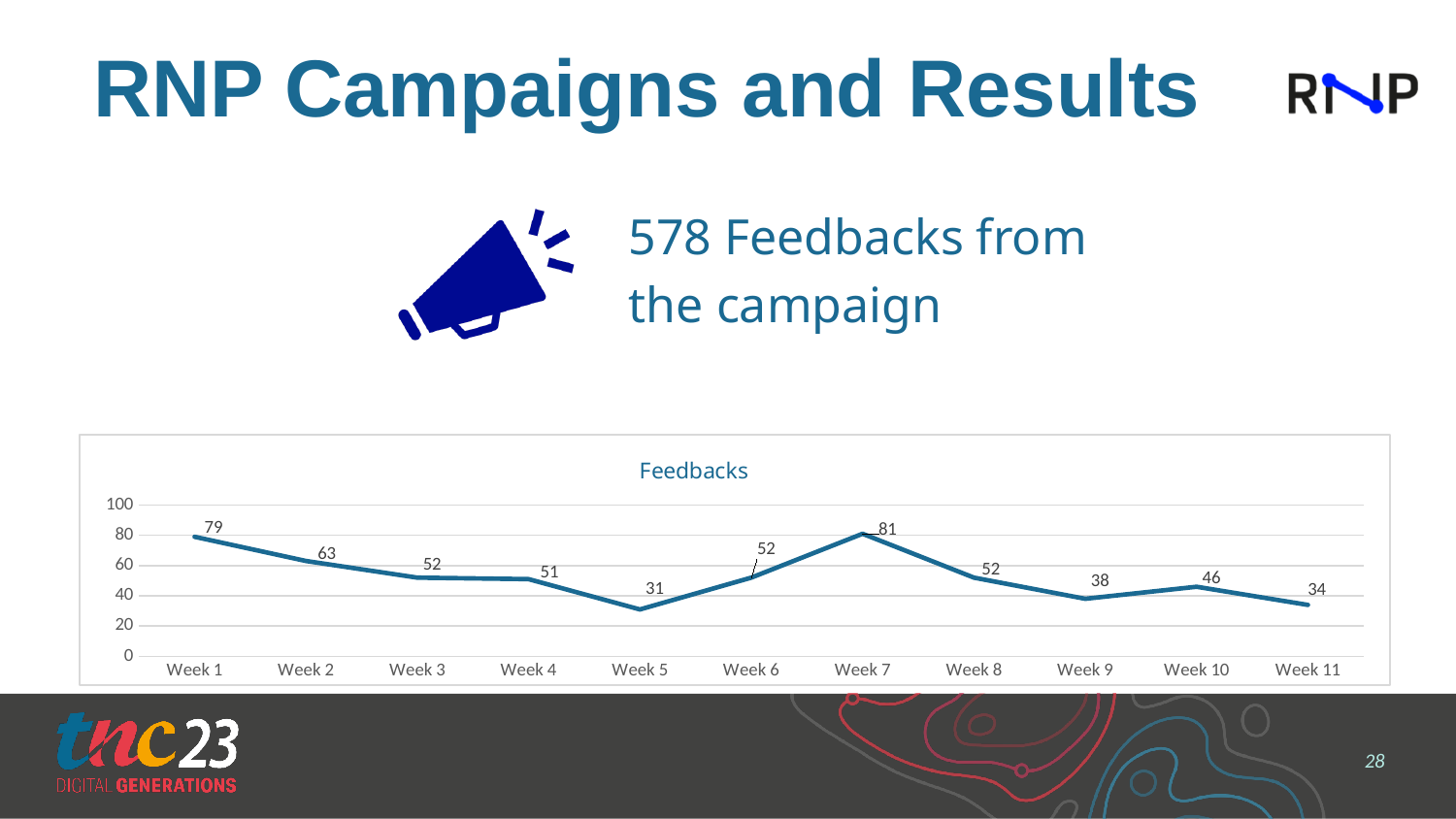
Does the value in the Feedbacks chart rise or fall from Week 1 to Week 5? fall What is the value for Week 1 in the Feedbacks chart? 79 Which week has the highest value in the Feedbacks chart? Week 7 How many weeks are plotted in the Feedbacks chart? 11 What kind of chart is the Feedbacks chart? line chart Is the value for Week 11 in the Feedbacks chart greater or less than 40? less What is the value for Week 9 in the Feedbacks chart? 38 What is the value for Week 5 in the Feedbacks chart? 31 Which week has the lowest value in the Feedbacks chart? Week 5 What is the title of the chart on the slide? Feedbacks Which is larger in the Feedbacks chart, the value for Week 2 or the value for Week 10? Week 2 What is the difference between the values for Week 7 and Week 5 in the Feedbacks chart? 50